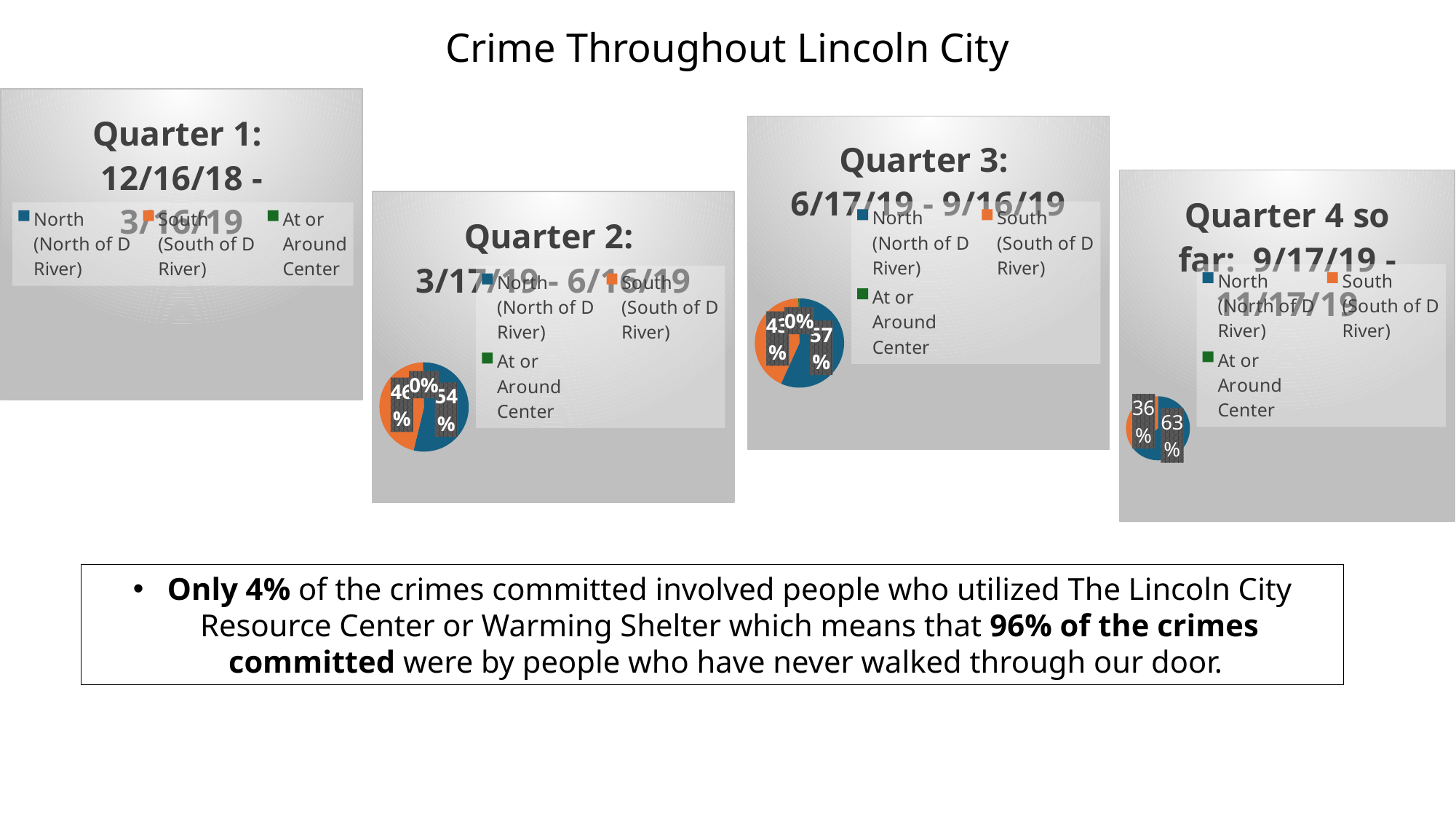
How many entries does the legend of the Quarter 3 chart list? 3 In the Quarter 4 so far chart, which category has the largest slice? North (North of D River) In the Quarter 4 so far chart, what share is labelled on the orange South (South of D River) slice? 36% In the Quarter 2 chart, what share is labelled on the orange South (South of D River) slice? 46% In the Quarter 3 chart, what share is labelled on the blue North (North of D River) slice? 57% In the Quarter 4 so far chart, what share is labelled on the blue North (North of D River) slice? 63% What kind of chart is used in the Quarter 2 panel? pie chart In the Quarter 3 chart, which slice is larger: North (North of D River) or South (South of D River)? North (North of D River) In the Quarter 2 chart, what is the difference between the North (North of D River) and South (South of D River) shares? 8% In the Quarter 2 chart, what share is labelled on the blue North (North of D River) slice? 54% In the Quarter 3 chart, what share is labelled on the orange South (South of D River) slice? 43% What is the title of the slide containing the quarterly pie charts? Crime Throughout Lincoln City